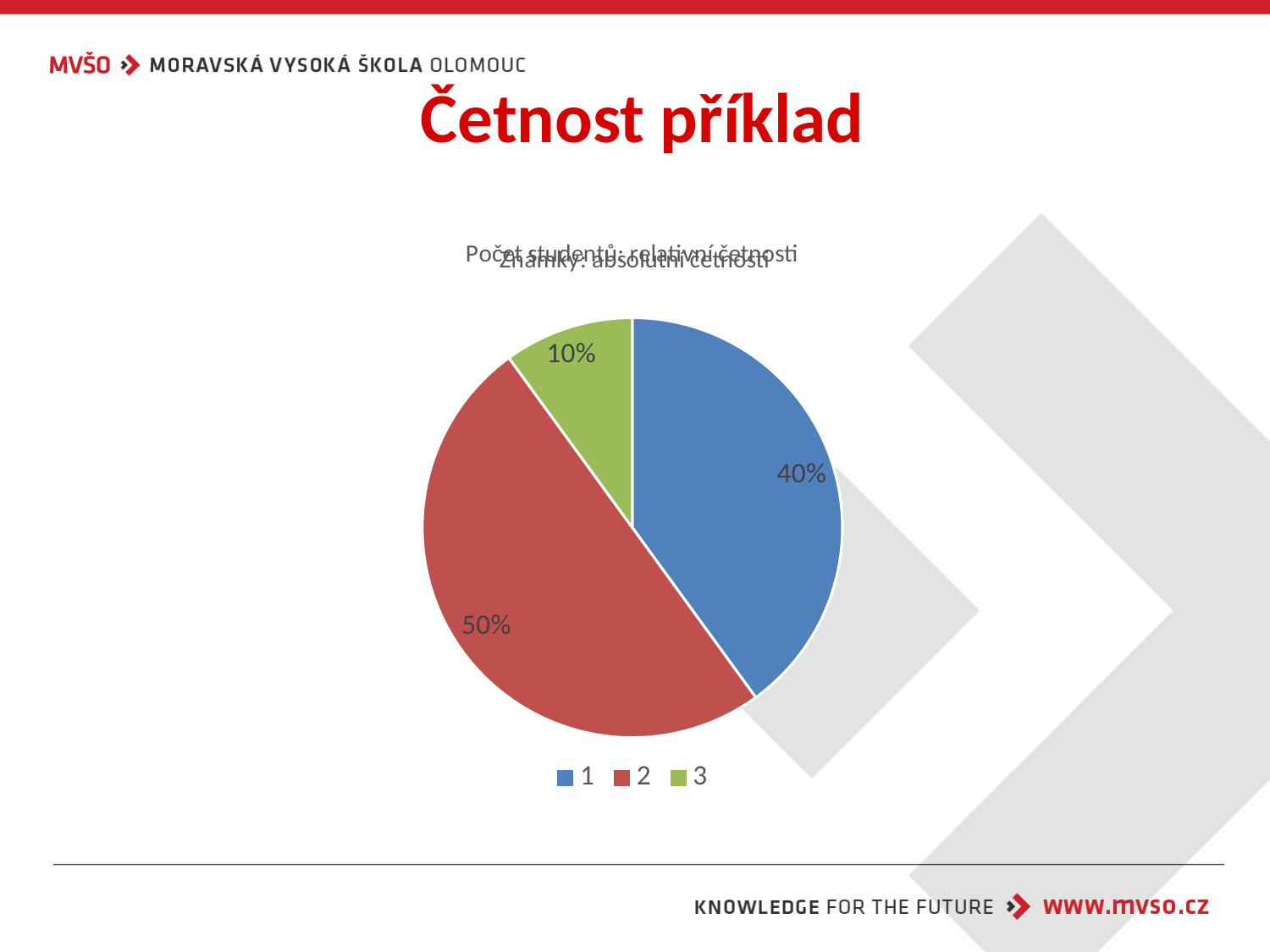
Which slice is larger, category 1 or category 3? 1 Which category has the smallest slice of the pie? 3 What colour is the slice for category 3? green What colour is the slice for category 2? red Which category has the largest slice of the pie? 2 How many slices does the pie chart have? 3 What kind of chart is shown on the slide? pie chart What share of the pie does category 2 have? 50% How many entries does the legend list? 3 What share of the pie does category 1 have? 40% What share of the pie does category 3 have? 10% What is the difference in percentage points between the slices for category 2 and category 1? 10